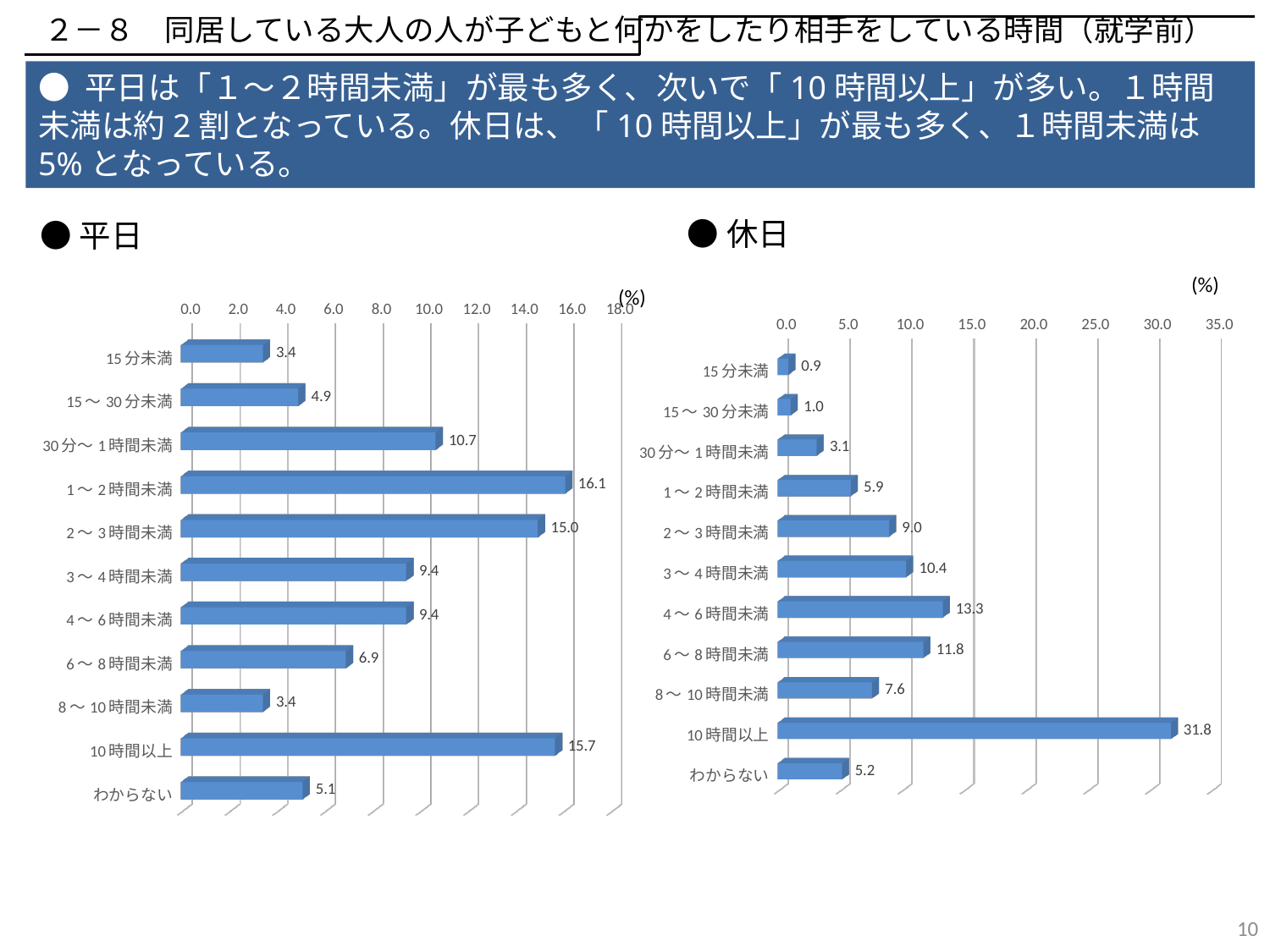
In the 平日 chart, how many categories are shown? 11 In the 平日 chart, what is the difference between 2～3時間未満 and 10時間以上? 0.7 In the 平日 chart, which category has the highest value? 1～2時間未満 In the 休日 (holiday) chart, what is the value for 10時間以上? 31.8 In the 休日 chart, what is the difference between 10時間以上 and 4～6時間未満? 18.5 What kind of chart is the 休日 chart? bar chart What unit is shown on the axis of the 平日 chart? % In the 休日 chart, which category has the lowest value? 15分未満 In the 休日 chart, what is the value for わからない? 5.2 In the 平日 (weekday) chart, what is the value for 1～2時間未満? 16.1 In the 平日 chart, which is larger: 30分～1時間未満 or 6～8時間未満? 30分～1時間未満 In the 休日 chart, is the value for 6～8時間未満 greater or less than 10.0? greater